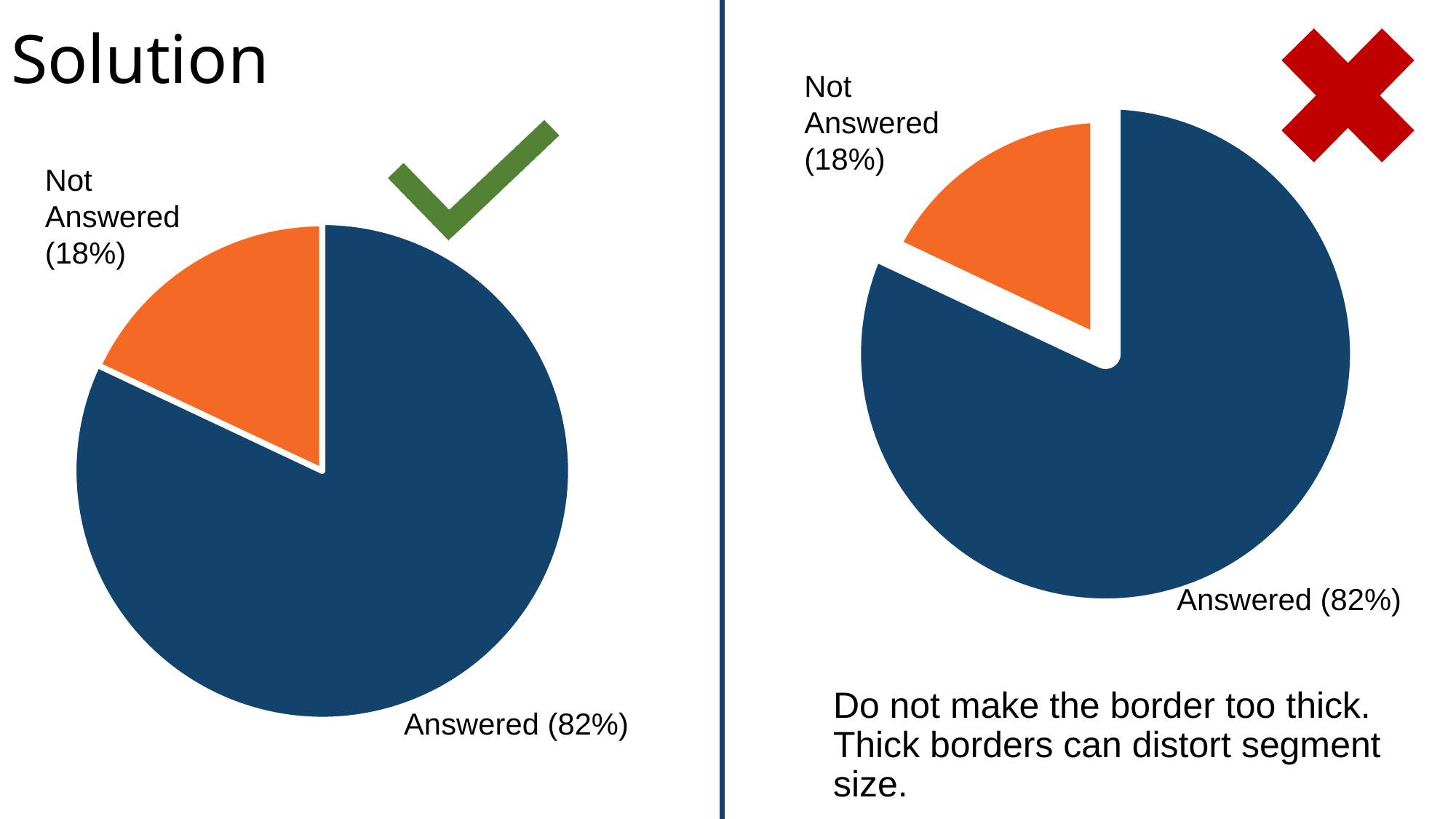
What kind of chart is shown on the right side of the slide? Pie chart In the left pie chart, what is the difference in percentage points between Answered and Not Answered? 64 In the right pie chart, which slice is the smallest? Not Answered How many slices does the left pie chart have? 2 In the right pie chart, what share is labelled for Not Answered? 18% In the left pie chart, what colour is the Not Answered slice? Orange In the left pie chart, what share is labelled for Answered? 82% In the right pie chart, what share is labelled for Answered? 82% In the right pie chart, which is larger, Answered or Not Answered? Answered In the left pie chart, which slice is the largest? Answered In the left pie chart, what share is labelled for Not Answered? 18% Which pie chart on the slide is marked with a red cross, the left or the right? Right